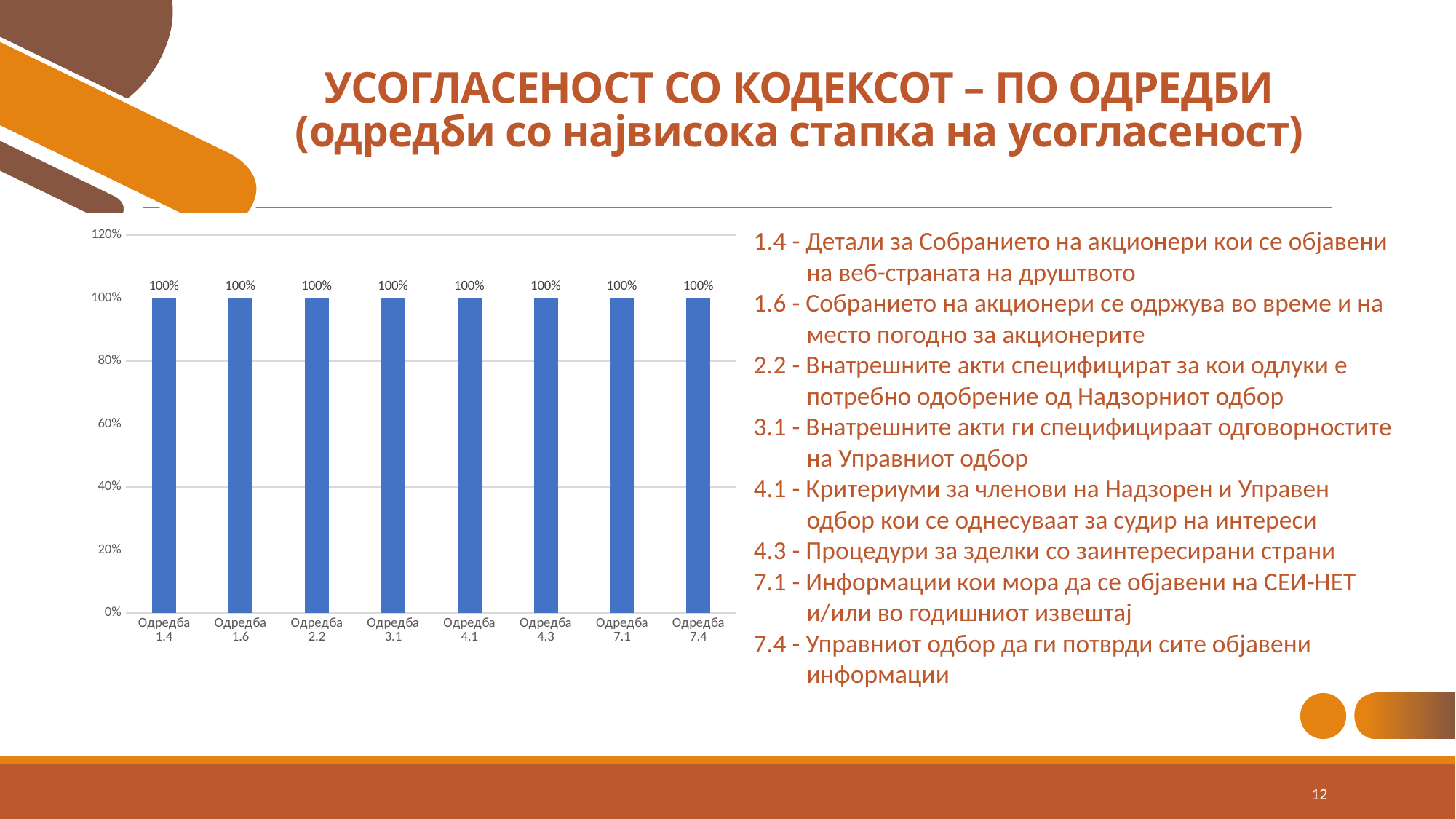
What is the highest value shown on the vertical axis? 120% What is the label of the first category on the left of the chart? Одредба 1.4 What is the difference between the values for Одредба 1.6 and Одредба 7.1? 0% Do the values rise, fall, or stay the same across the categories from left to right? stay the same How many categories (одредби) are shown in the chart? 8 What is the value for Одредба 1.4? 100% What is the value for Одредба 4.3? 100% Is the value for Одредба 3.1 greater or less than 80%? greater What is the value for Одредба 2.2? 100% What kind of chart is shown on the slide? bar chart What is the value for Одредба 7.4? 100%